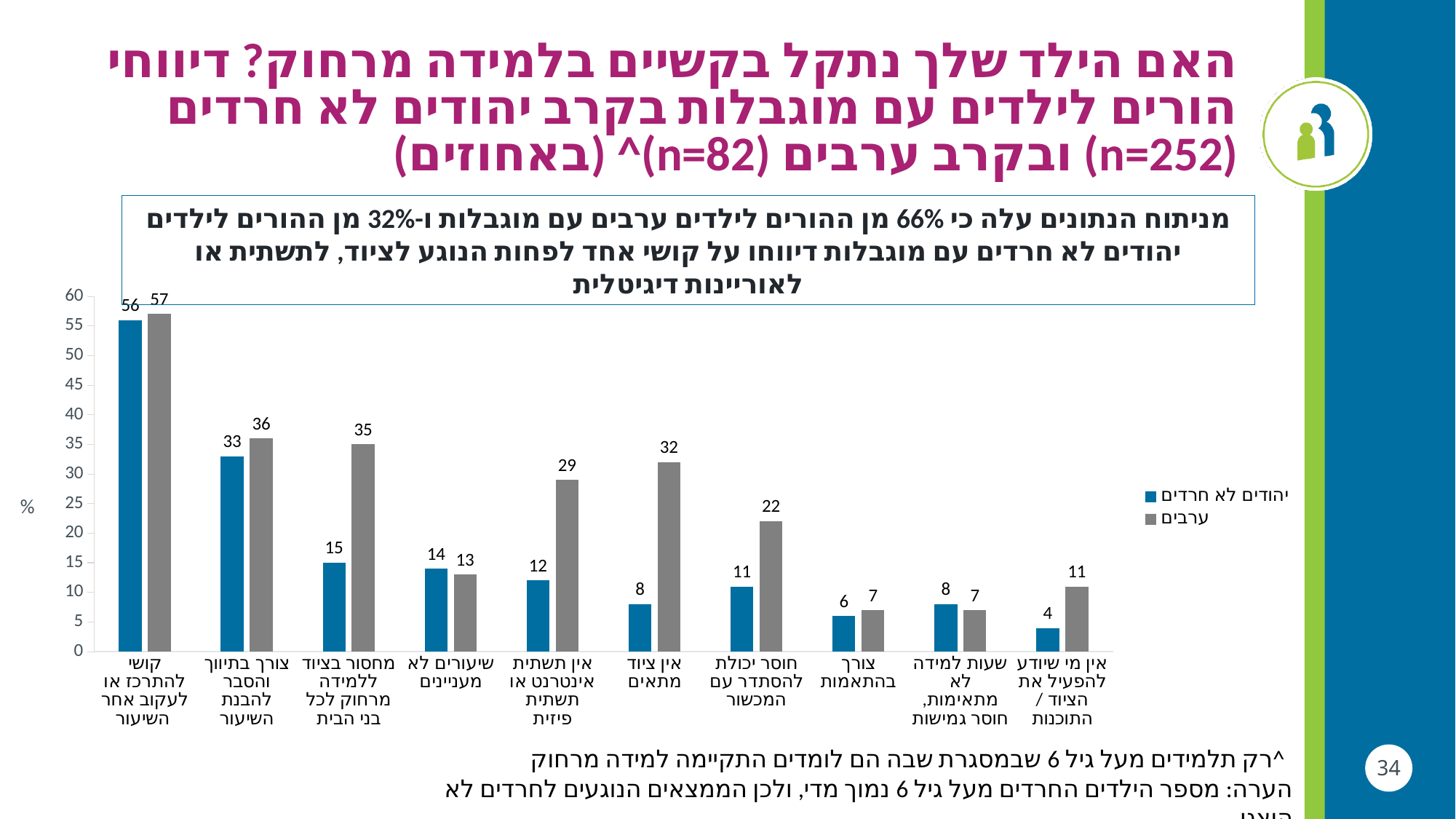
What is the difference between the ערבים and יהודים לא חרדים values in the category אין ציוד מתאים? 24 Which category has the highest value for ערבים? קושי להתרכז או לעקוב אחר השיעור Which colour represents the series ערבים in the chart? gray What is the value for יהודים לא חרדים in the category אין ציוד מתאים? 8 In the category שיעורים לא מעניינים, which series has the larger value, יהודים לא חרדים or ערבים? יהודים לא חרדים What type of chart is shown on the slide? bar chart How many series does the legend list? 2 What is the value for ערבים in the category מחסור בציוד ללמידה מרחוק לכל בני הבית? 35 What is the difference between the ערבים and יהודים לא חרדים values in the category אין תשתית אינטרנט או תשתית פיזית? 17 What is the value for ערבים in the category חוסר יכולת להסתדר עם המכשור? 22 How many categories are shown on the x axis of the chart? 10 Which category has the lowest value for יהודים לא חרדים? אין מי שיודע להפעיל את הציוד / התוכנות